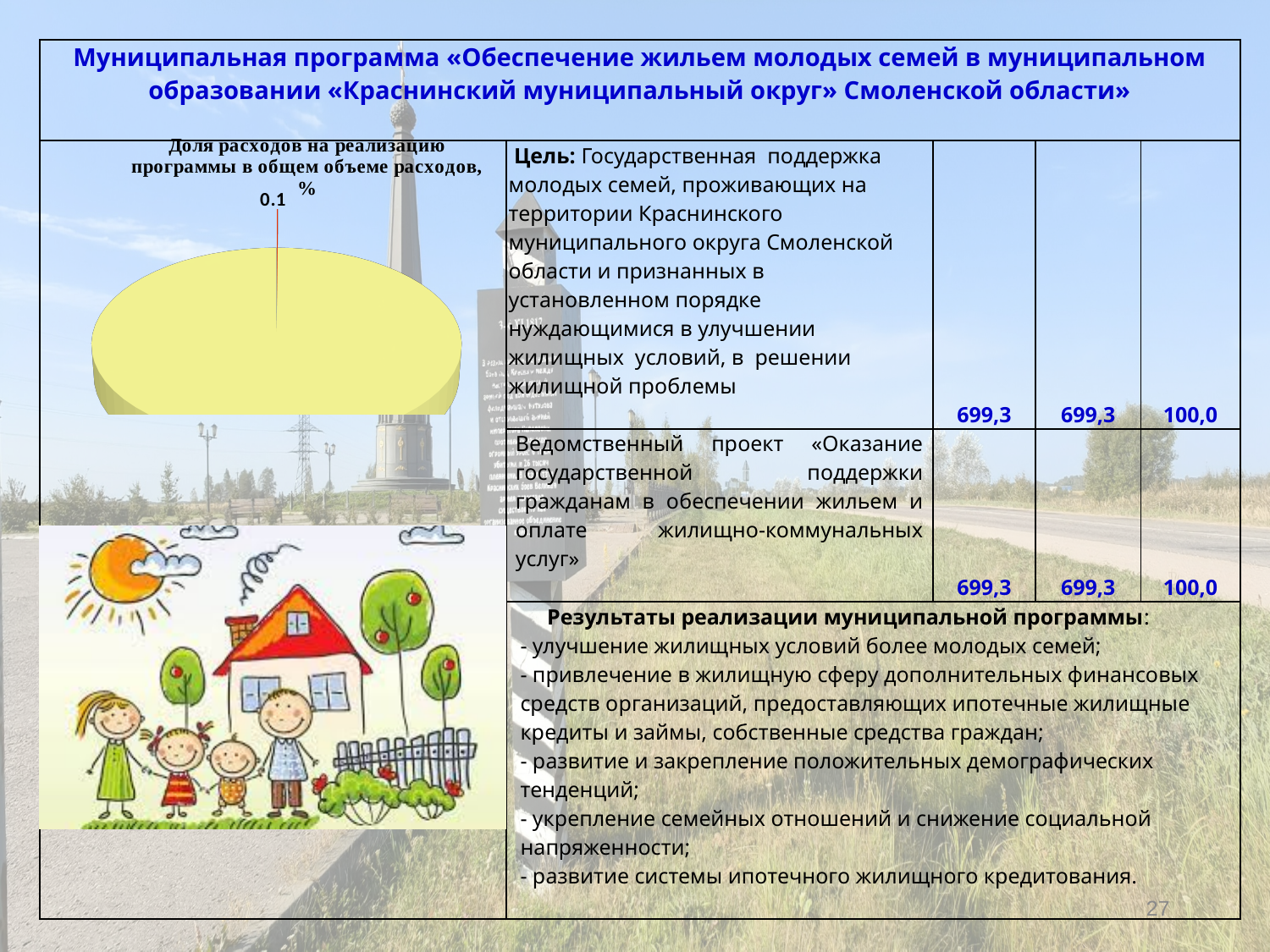
What is the share of the small slice labelled on the pie chart? 0.1 Is the labelled slice of the pie chart greater or less than 50% of the pie? less How many data labels are printed on the pie chart? 1 What is the title of the pie chart? Доля расходов на реализацию программы в общем объеме расходов, % What value is printed as a data label on the pie chart? 0.1 What colour is the large slice of the pie chart? yellow What kind of chart is shown on the left of the slide? pie chart